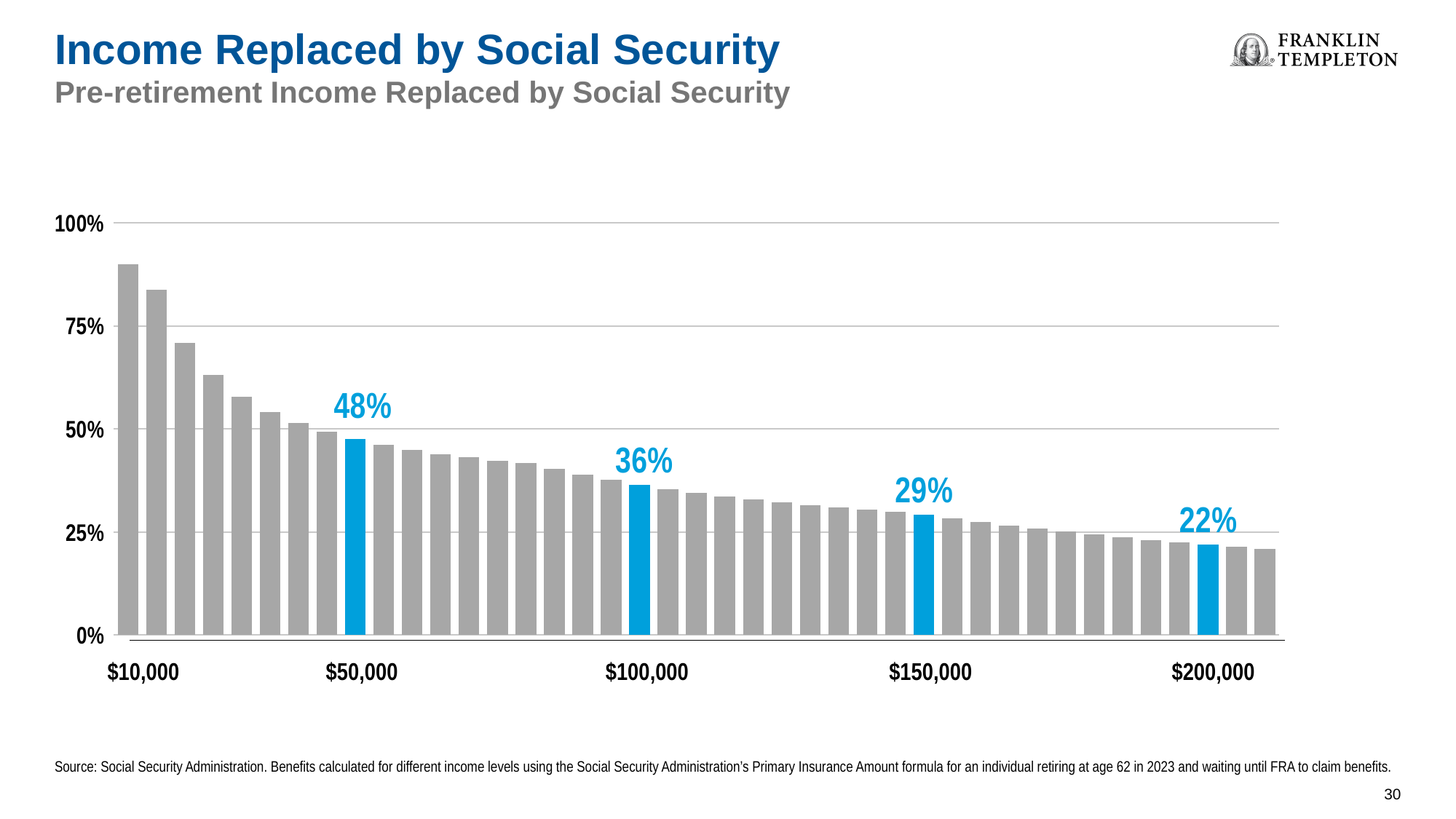
What percentage of pre-retirement income is replaced by Social Security at the $200,000 income level? 22% What percentage of pre-retirement income is replaced by Social Security at the $150,000 income level? 29% What colour are the highlighted bars with data labels? Blue Which income level has the higher replacement rate, $50,000 or $150,000? $50,000 What percentage of pre-retirement income is replaced by Social Security at the $100,000 income level? 36% Is the replacement rate for the rightmost bar (highest income level) greater or less than 25%? less What type of chart is shown on the slide? Bar chart What is the difference in percentage points between the replacement rate at $50,000 and at $200,000? 26 percentage points Is the replacement rate for the $10,000 income level greater or less than 75%? greater How does the share of income replaced by Social Security change as pre-retirement income increases along the x axis? It falls What percentage of pre-retirement income is replaced by Social Security at the $50,000 income level? 48% What is the difference in percentage points between the replacement rate at $100,000 and at $150,000? 7 percentage points